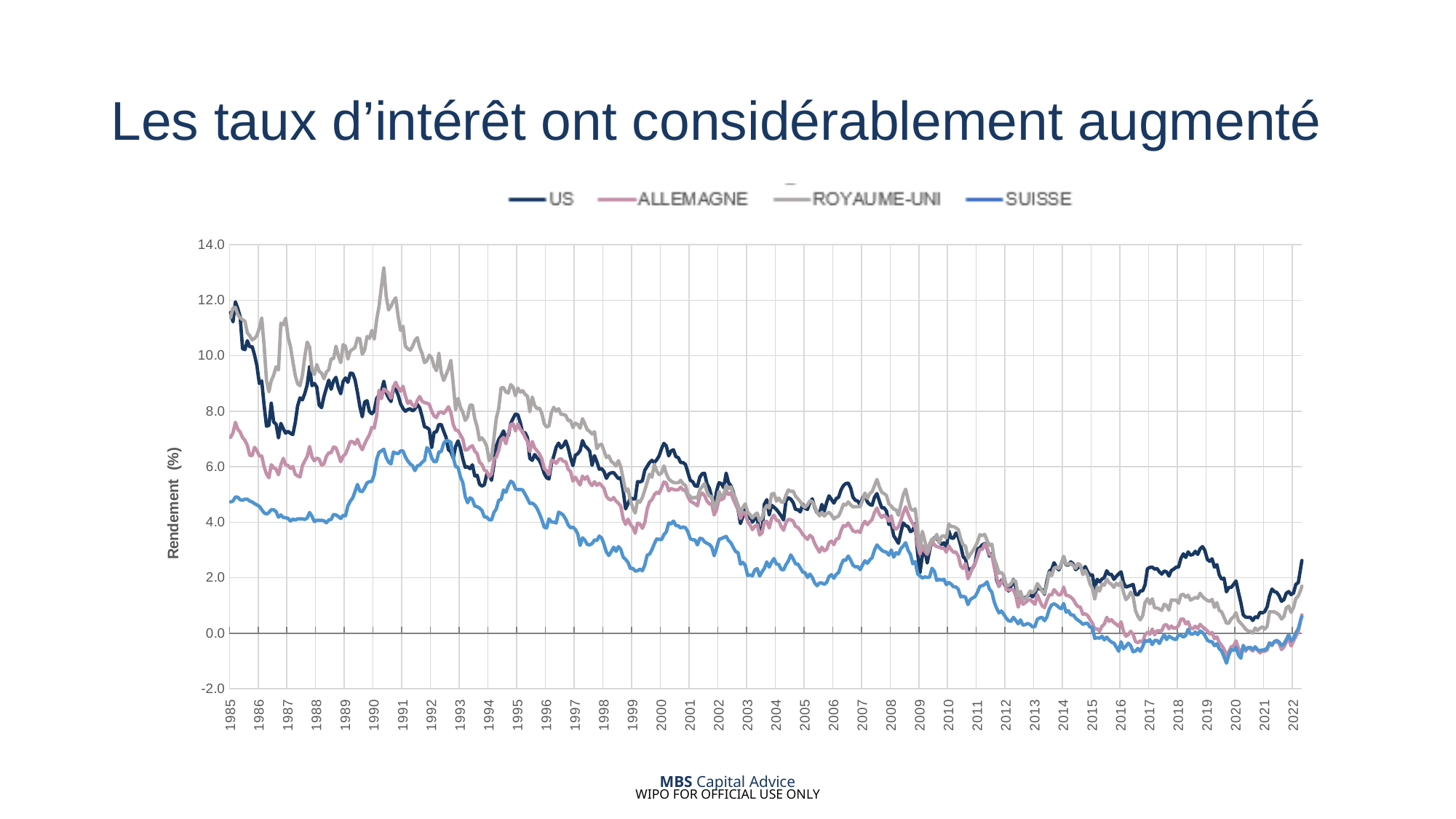
Which series reaches the highest value anywhere on the chart? ROYAUME-UNI Is the peak value of the ROYAUME-UNI series around 1990 greater or less than 12.0? greater Overall, do the plotted yields rise or fall from 1985 to 2022? fall Which series has the lowest value at the start of the chart in 1985? SUISSE What is the title of the slide above the chart? Les taux d'intérêt ont considérablement augmenté Which series are listed in the chart legend? US, ALLEMAGNE, ROYAUME-UNI, SUISSE What kind of chart is shown on the slide? line chart Is the value for ALLEMAGNE in 1985 greater or less than 8.0? less How many series does the legend list? 4 How many year labels are shown on the x axis? 38 In 1985, which is higher, the US series or the SUISSE series? US Is the value for SUISSE in 1985 greater or less than 6.0? less